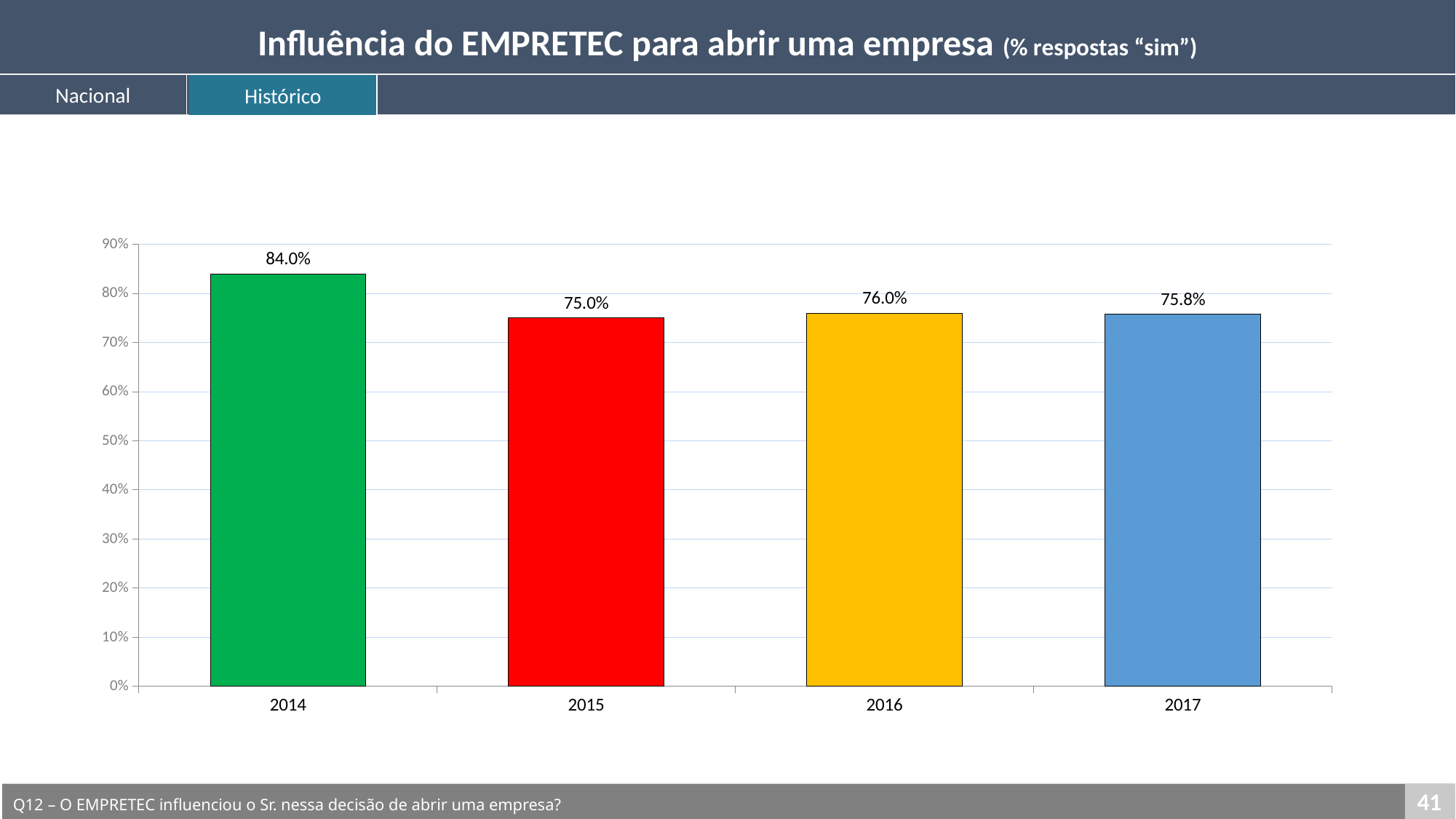
How many years are shown on the chart? 4 What is the value for 2014? 84.0% What is the value for 2015? 75.0% Which year has the highest value? 2014 Is the value for 2017 greater or less than 80%? less Which year has the lowest value? 2015 What is the value for 2017? 75.8% What is the value for 2016? 76.0% What is the difference between the values for 2016 and 2017? 0.2% What is the difference between the values for 2014 and 2015? 9.0% What kind of chart is shown on the slide? bar chart Which is larger, the value for 2014 or the value for 2016? 2014